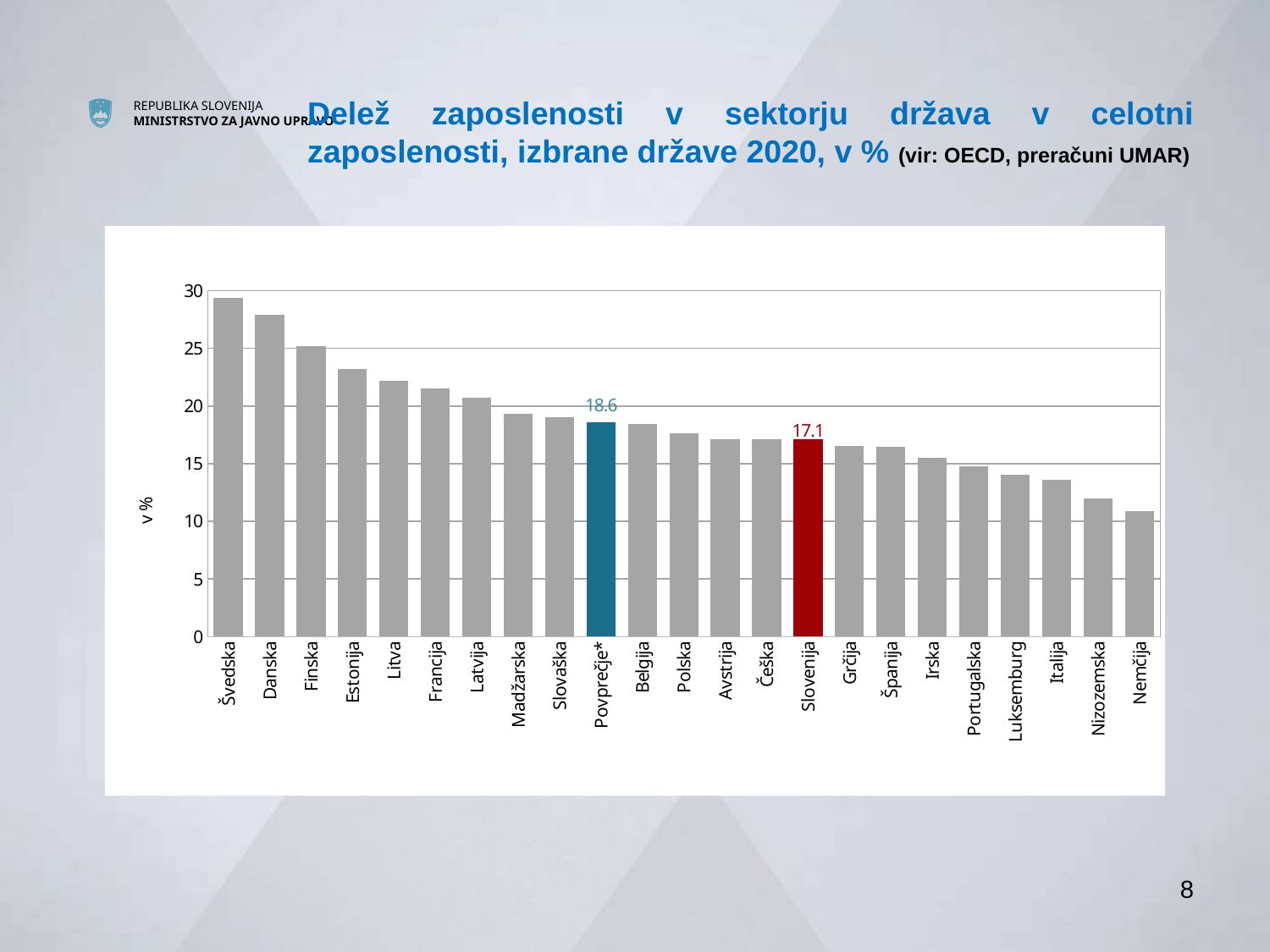
Which is larger, the value for Danska or the value for Italija? Danska What is the difference between the value for Povprečje* and the value for Slovenija? 1.5 Do the values rise or fall from left to right along the x axis? fall Is the value for Italija greater or less than 15? less Which country has the lowest bar? Nemčija What kind of chart is shown on the slide? bar chart What is the value shown for Povprečje*? 18.6 How many bars are shown in the chart? 23 What is the value shown for Slovenija? 17.1 Is the value for Nemčija greater or less than 10? greater Which country has the highest bar? Švedska Is the value for Švedska greater or less than 25? greater